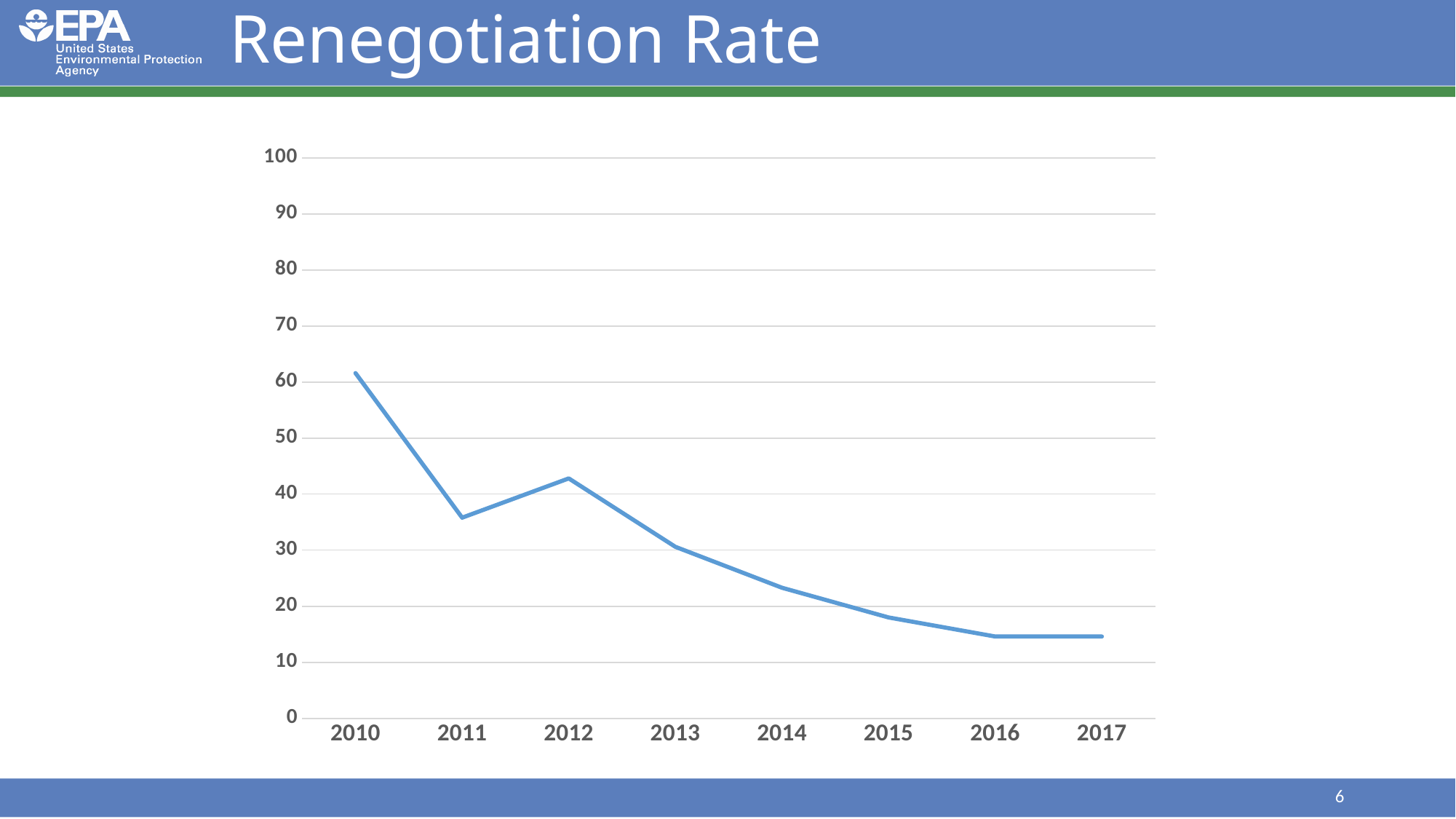
Is the value for 2011 greater or less than 40? less Which year has the larger value, 2011 or 2012? 2012 How many years are plotted along the x axis of the chart? 8 Which year has the highest renegotiation rate? 2010 Overall, does the renegotiation rate rise or fall from 2010 to 2017? fall Is the value for 2012 greater or less than 40? greater What kind of chart is shown on the slide? line chart Is the value for 2015 greater or less than 20? less What is the title of the slide containing the chart? Renegotiation Rate